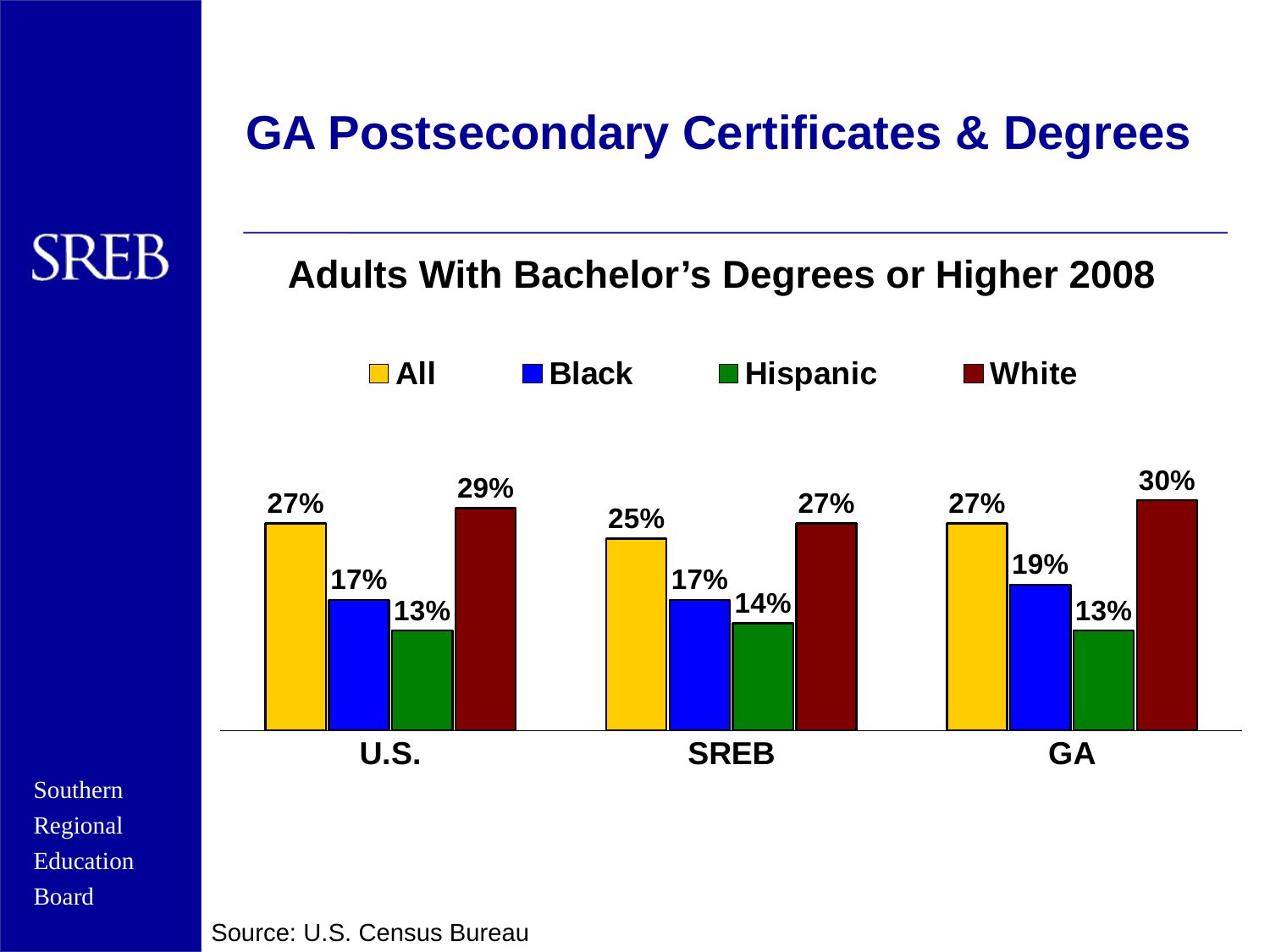
How many categories are shown on the x axis? 3 How many series does the legend list? 4 What kind of chart is shown? Bar chart What is the value for All in SREB? 25% Which series has the highest value in GA? White What is the difference between the White and Black values in GA? 11% What is the difference between the All values for the U.S. and SREB? 2% Which series has the lowest value in the U.S.? Hispanic What is the value for White in GA? 30% What is the value for Black in SREB? 17% Which is larger, the Black value in GA or the Black value in SREB? GA What is the value for Hispanic in the U.S.? 13%